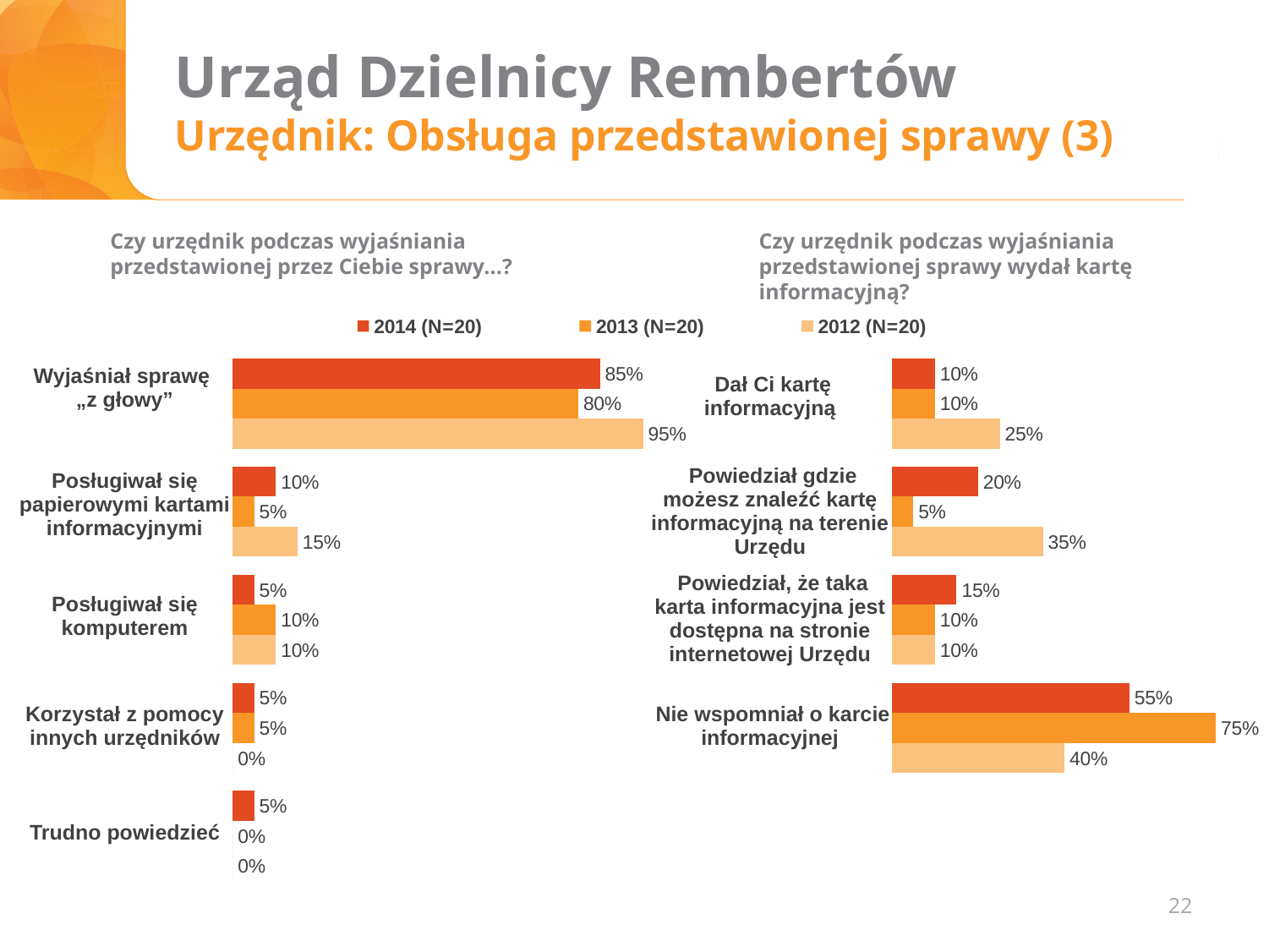
In the right chart, which is larger for "Powiedział gdzie możesz znaleźć kartę informacyjną na terenie Urzędu": the 2014 value or the 2012 value? 2012 In the left chart, what is the 2013 value for "Trudno powiedzieć"? 0% What type of chart is used on the slide? Bar chart In the right chart, what is the 2012 value for "Dał Ci kartę informacyjną"? 25% How many series does the legend list? 3 In the left chart, how many categories are shown? 5 In the right chart ("Czy urzędnik podczas wyjaśniania przedstawionej sprawy wydał kartę informacyjną?"), what is the 2013 value for "Nie wspomniał o karcie informacyjnej"? 75% In the left chart, which category has the highest 2012 value? Wyjaśniał sprawę „z głowy” In the left chart, what is the 2012 value for "Posługiwał się papierowymi kartami informacyjnymi"? 15% In the left chart, what is the difference between the 2012 and 2013 values for "Wyjaśniał sprawę „z głowy”"? 15% In the left chart ("Czy urzędnik podczas wyjaśniania przedstawionej przez Ciebie sprawy...?"), what is the 2014 value for "Wyjaśniał sprawę „z głowy”"? 85% In the right chart, what is the difference between the 2013 and 2012 values for "Nie wspomniał o karcie informacyjnej"? 35%